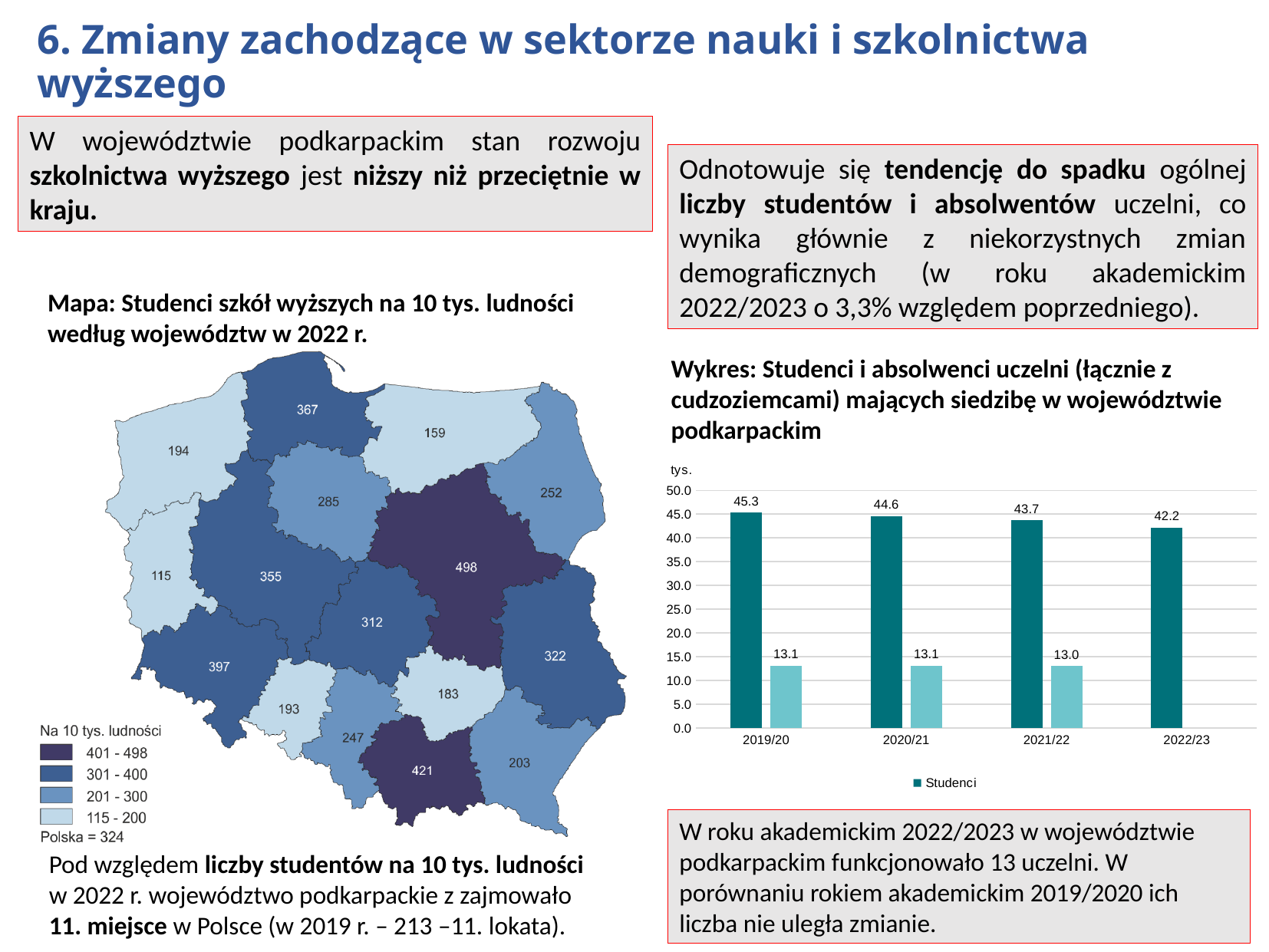
In the chart 'Studenci i absolwenci uczelni', what is the difference between the Studenci values for 2019/20 and 2022/23? 3.1 In the chart 'Studenci i absolwenci uczelni', what is the value of the Studenci bar for 2019/20? 45.3 In the chart 'Studenci i absolwenci uczelni', which is larger: the Studenci value for 2020/21 or for 2021/22? 2020/21 How many academic years are shown on the x axis of the chart 'Studenci i absolwenci uczelni'? 4 In the chart 'Studenci i absolwenci uczelni', what is the value of the lighter bar for 2021/22? 13.0 In the chart 'Studenci i absolwenci uczelni', what is the value of the Studenci bar for 2022/23? 42.2 What kind of chart is 'Studenci i absolwenci uczelni'? bar chart In the chart 'Studenci i absolwenci uczelni', which academic year has the highest Studenci value? 2019/20 In the chart 'Studenci i absolwenci uczelni', do the Studenci values rise or fall from 2019/20 to 2022/23? fall What unit label is shown above the y axis of the chart 'Studenci i absolwenci uczelni'? tys. In the chart 'Studenci i absolwenci uczelni', which academic year has the lowest Studenci value? 2022/23 In the chart 'Studenci i absolwenci uczelni', is the Studenci value for 2021/22 greater or less than 40.0? greater